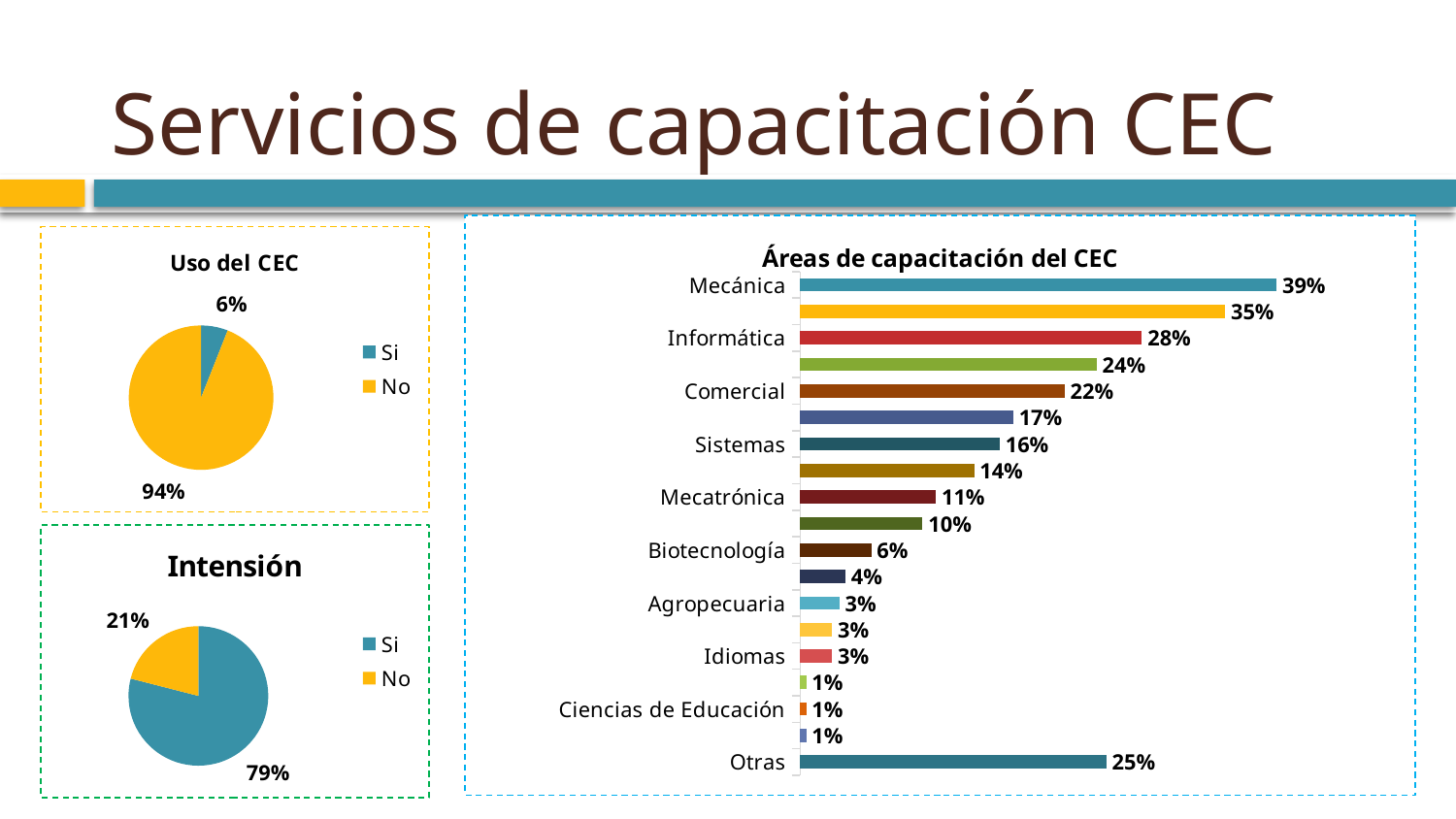
In the 'Intensión' pie chart, which slice is larger, 'Si' or 'No'? Si What kind of chart is 'Áreas de capacitación del CEC'? Bar chart In the 'Áreas de capacitación del CEC' chart, what is the value for Otras? 25% In the 'Uso del CEC' pie chart, what share of the pie does 'Si' have? 6% In the 'Uso del CEC' pie chart, what percentage is shown for 'No'? 94% In the 'Intensión' pie chart, what is the difference between the 'Si' and 'No' slices? 58% In the 'Áreas de capacitación del CEC' chart, what is the value for Mecánica? 39% In the 'Áreas de capacitación del CEC' chart, which is larger, Sistemas or Mecatrónica? Sistemas In the 'Áreas de capacitación del CEC' chart, what is the difference between Informática and Comercial? 6% How many entries does the legend of the 'Uso del CEC' pie chart list? 2 In the 'Áreas de capacitación del CEC' chart, which labelled area has the highest value? Mecánica In the 'Intensión' pie chart, what percentage is shown for 'Si'? 79%